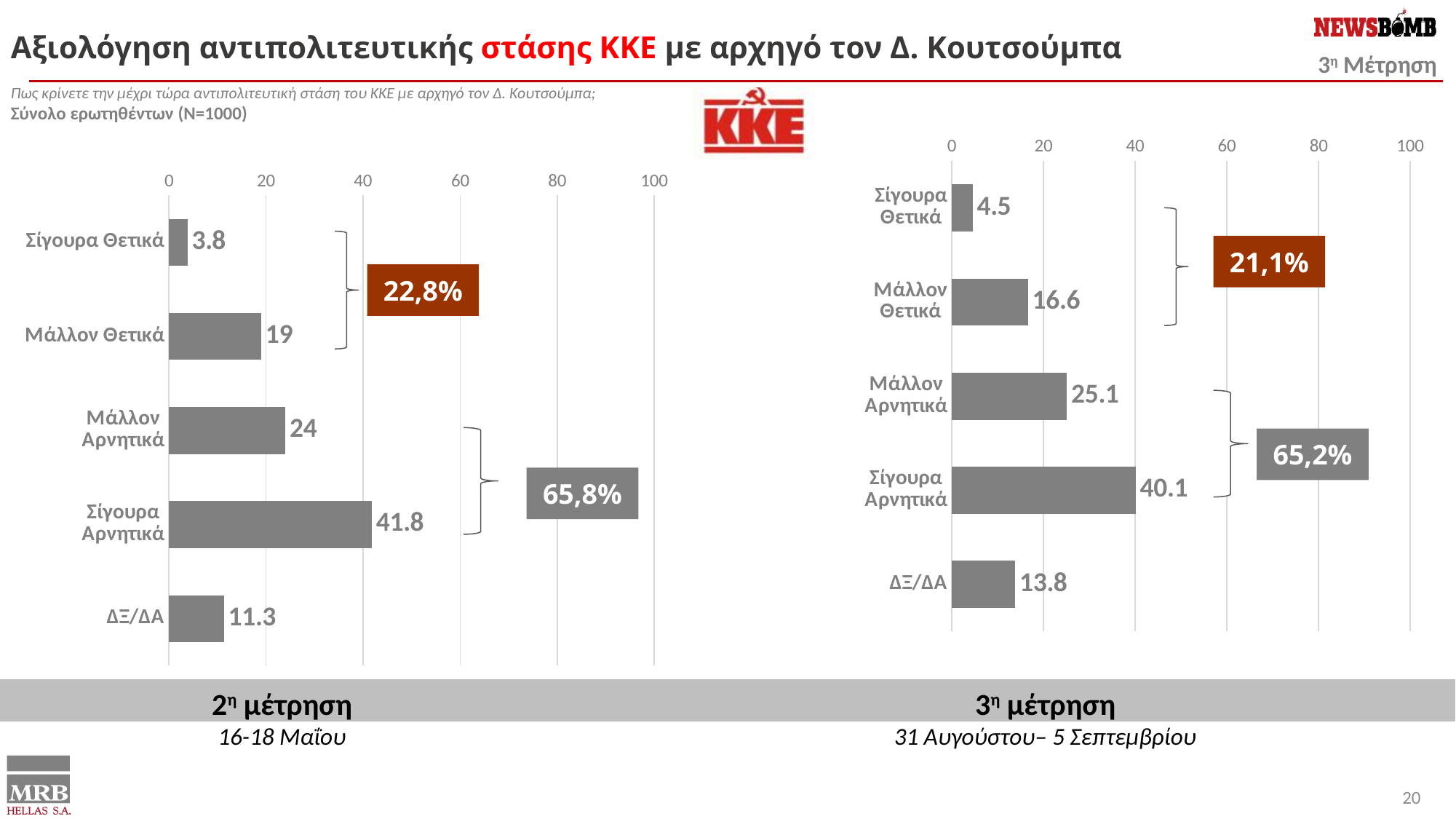
How many categories are shown in the 3η μέτρηση chart (right)? 5 In the 2η μέτρηση chart (left), is the value for Σίγουρα Αρνητικά greater or less than 40? greater In the 2η μέτρηση chart (left), what is the value for Σίγουρα Αρνητικά? 41.8 In the 3η μέτρηση chart (right), what combined percentage is shown in the box for the two negative categories? 65,2% In the 3η μέτρηση chart (right), what is the difference between Σίγουρα Αρνητικά and Σίγουρα Θετικά? 35.6 In the 3η μέτρηση chart (right), what is the value for ΔΞ/ΔΑ? 13.8 In the 2η μέτρηση chart (left), which category has the highest value? Σίγουρα Αρνητικά Which is larger: Μάλλον Θετικά in the 2η μέτρηση chart (left) or Μάλλον Θετικά in the 3η μέτρηση chart (right)? 2η μέτρηση (19) In the 3η μέτρηση chart (right), which category has the lowest value? Σίγουρα Θετικά What type of chart is the 2η μέτρηση chart (left)? bar chart In the 2η μέτρηση chart (left), what is the difference between Σίγουρα Αρνητικά and Μάλλον Αρνητικά? 17.8 In the 3η μέτρηση chart (right), what is the value for Μάλλον Θετικά? 16.6